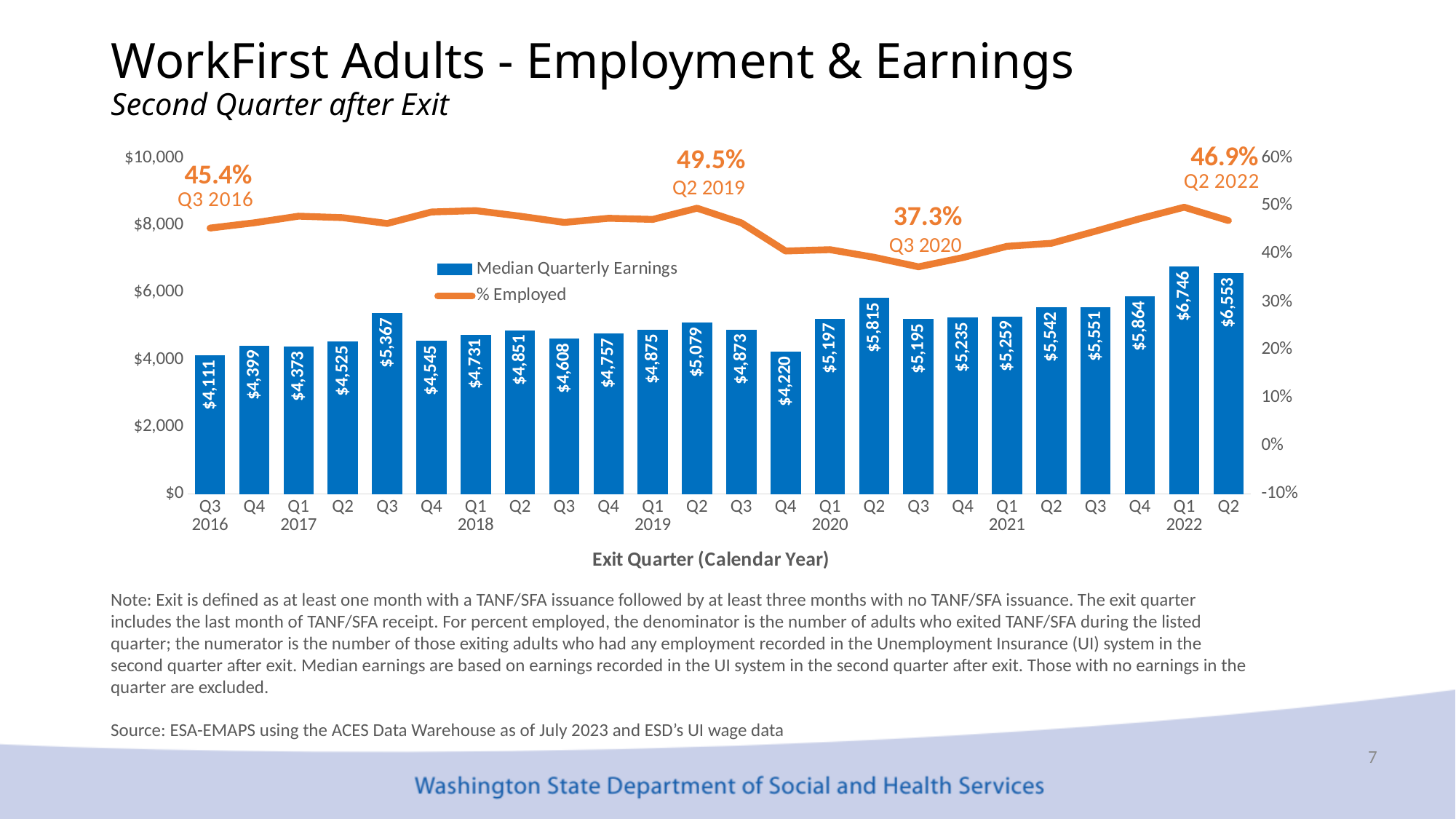
What percent employed is labeled for Q3 2020? 37.3% How many exit quarters are shown on the chart? 24 What kind of chart is shown on the slide? Combination bar and line chart What percent employed is labeled for Q2 2019? 49.5% Which exit quarter has the highest median quarterly earnings? Q1 2022 What is the median quarterly earnings value for Q4 2019? $4,220 What is the difference in median quarterly earnings between Q1 2022 and Q2 2022? $193 How many series does the legend list? 2 Is the % Employed value for Q1 2018 greater or less than 40%? greater Which exit quarter has the lowest median quarterly earnings? Q3 2016 What is the median quarterly earnings value for Q3 2017? $5,367 Which has higher median quarterly earnings, Q2 2020 or Q1 2020? Q2 2020